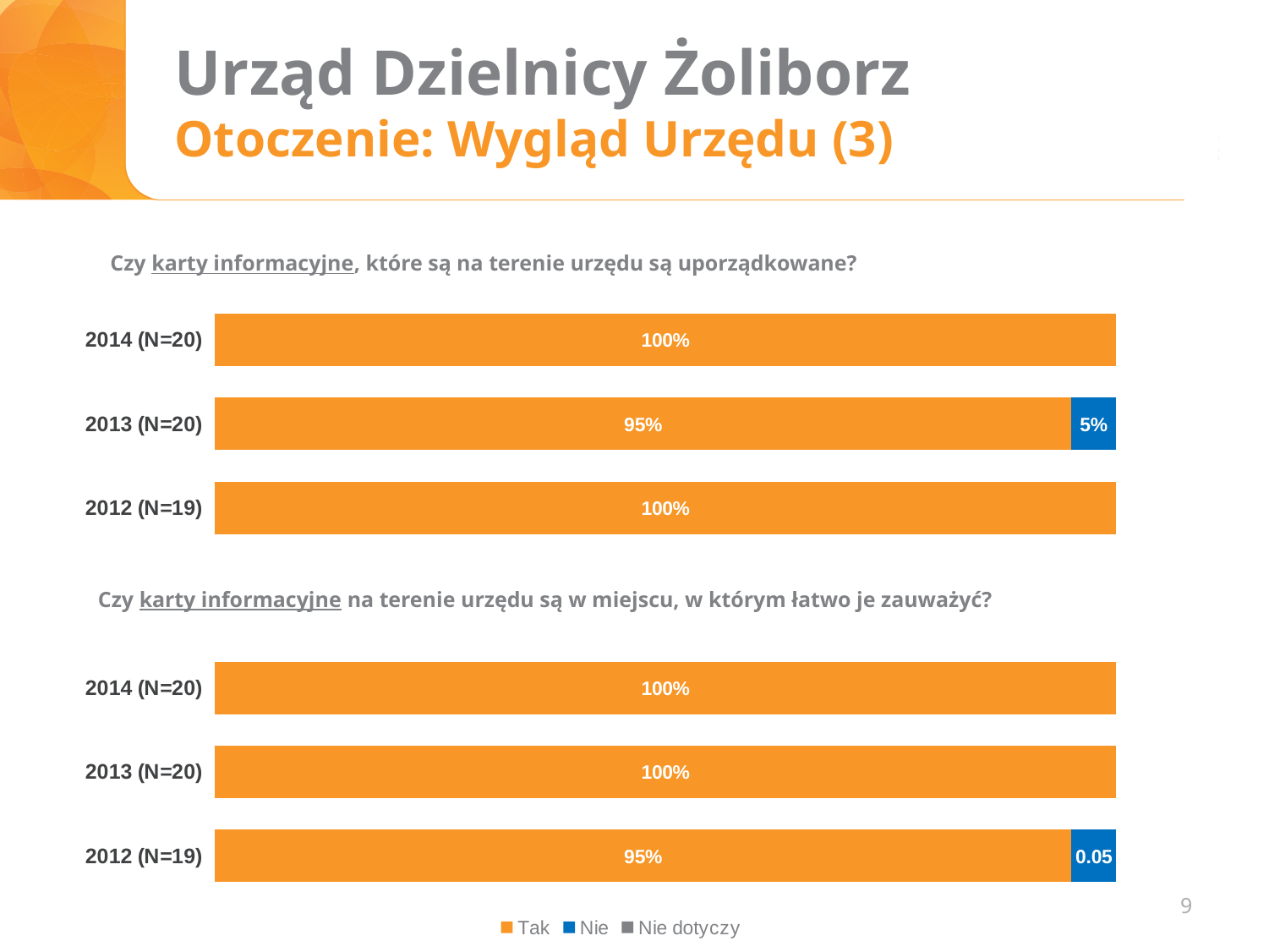
In the top chart ("Czy karty informacyjne, które są na terenie urzędu są uporządkowane?"), what is the value for Tak in 2014 (N=20)? 100% How many series does the legend at the bottom of the slide list? 3 In the top chart ("Czy karty informacyjne, które są na terenie urzędu są uporządkowane?"), what is the value for Nie in 2013 (N=20)? 5% In the top chart ("Czy karty informacyjne, które są na terenie urzędu są uporządkowane?"), which year has the lowest Tak value? 2013 (N=20) In the bottom chart ("Czy karty informacyjne na terenie urzędu są w miejscu, w którym łatwo je zauważyć?"), what is the value for Tak in 2012 (N=19)? 95% In the top chart ("Czy karty informacyjne, które są na terenie urzędu są uporządkowane?"), what is the difference between the Tak values for 2014 (N=20) and 2013 (N=20)? 5% In the bottom chart ("Czy karty informacyjne na terenie urzędu są w miejscu, w którym łatwo je zauważyć?"), which year has the lowest Tak value? 2012 (N=19) How many year categories does the top chart ("Czy karty informacyjne, które są na terenie urzędu są uporządkowane?") show? 3 In the bottom chart ("Czy karty informacyjne na terenie urzędu są w miejscu, w którym łatwo je zauważyć?"), is the Tak value for 2013 (N=20) larger or smaller than for 2012 (N=19)? larger What type of chart is the bottom chart ("Czy karty informacyjne na terenie urzędu są w miejscu, w którym łatwo je zauważyć?")? Stacked horizontal bar chart In the bottom chart ("Czy karty informacyjne na terenie urzędu są w miejscu, w którym łatwo je zauważyć?"), what label is printed on the Nie segment for 2012 (N=19)? 0.05 In the top chart ("Czy karty informacyjne, które są na terenie urzędu są uporządkowane?"), what is the value for Tak in 2013 (N=20)? 95%